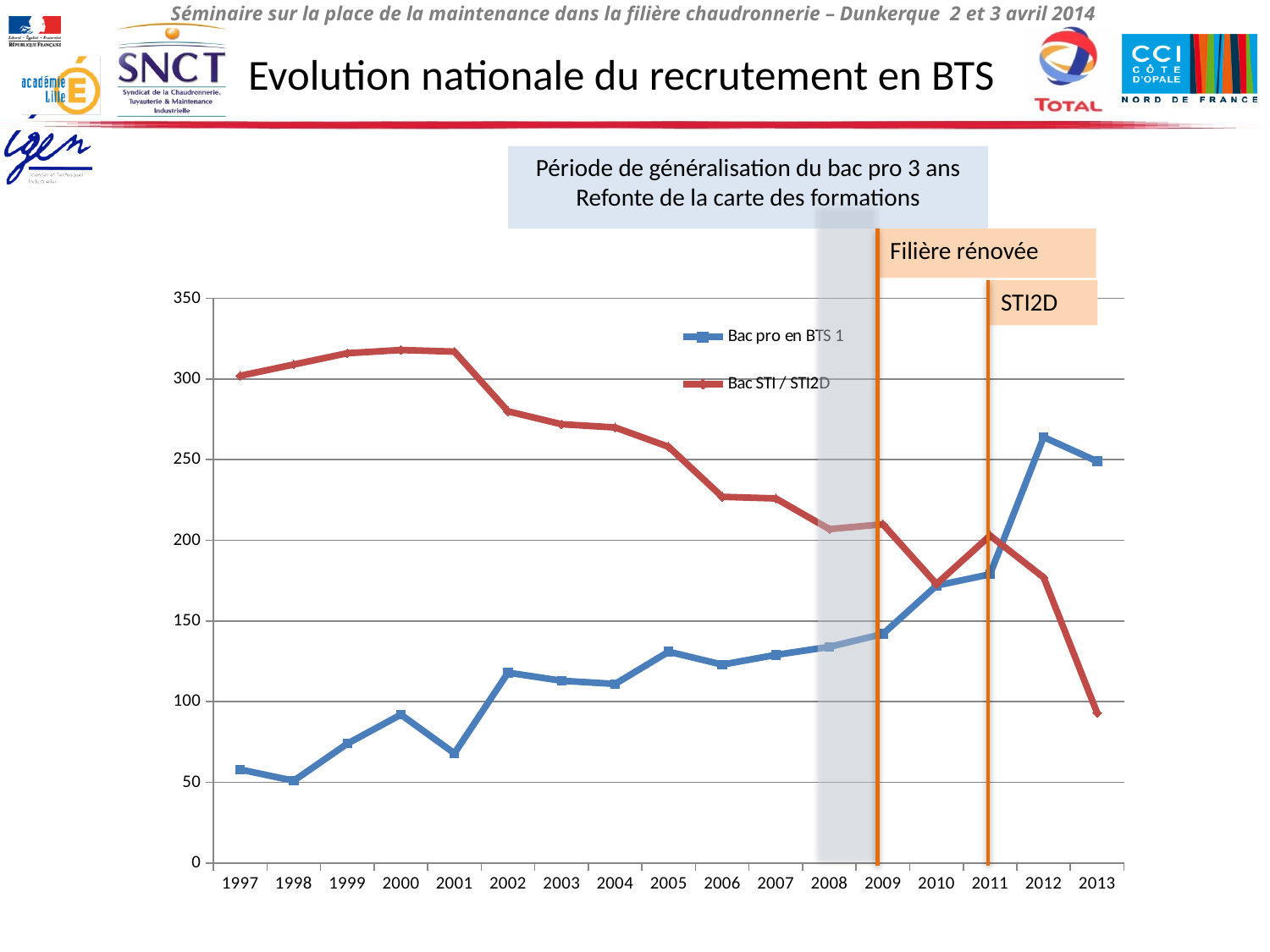
How many series does the legend list? 2 What is the title of the chart? Evolution nationale du recrutement en BTS In 2005, which series has the larger value, 'Bac pro en BTS 1' or 'Bac STI / STI2D'? Bac STI / STI2D Is the value for 'Bac STI / STI2D' in 2013 greater or less than 100? less In 2013, which series has the larger value, 'Bac pro en BTS 1' or 'Bac STI / STI2D'? Bac pro en BTS 1 Is the value for 'Bac pro en BTS 1' in 2012 greater or less than 250? greater In which year does the 'Bac STI / STI2D' series reach its lowest value? 2013 How many years are plotted along the x axis? 17 In which year does the 'Bac pro en BTS 1' series reach its highest value? 2012 What kind of chart is shown on the slide? line chart Does the 'Bac STI / STI2D' series generally rise or fall from 1997 to 2013? fall